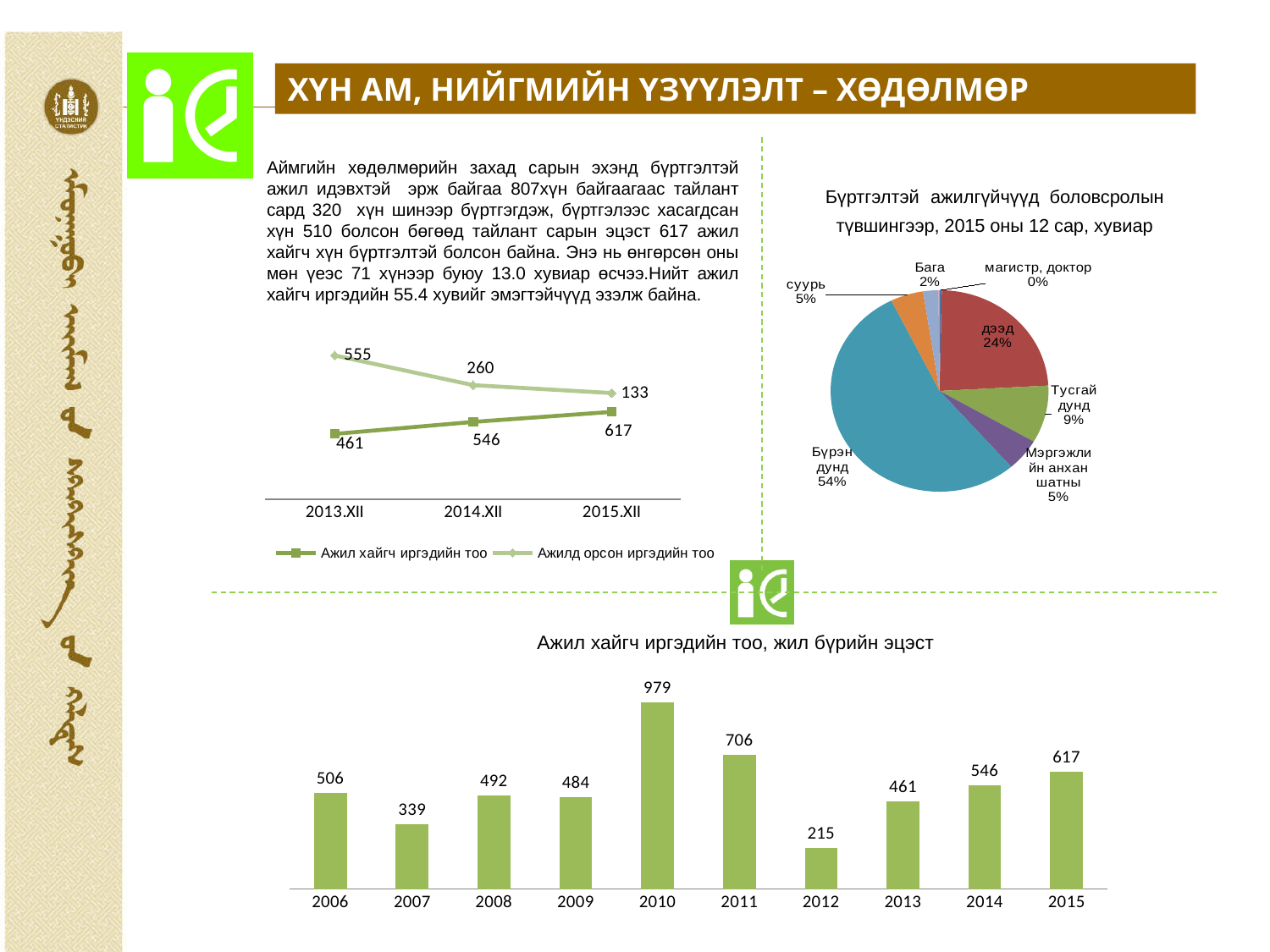
In the bar chart titled "Ажил хайгч иргэдийн тоо, жил бүрийн эцэст", how many years are shown? 10 In the pie chart titled "Бүртгэлтэй ажилгүйчүүд боловсролын түвшингээр, 2015 оны 12 сар, хувиар", which category has the largest share? Бүрэн дунд In the bar chart titled "Ажил хайгч иргэдийн тоо, жил бүрийн эцэст", what is the difference between the values for 2015 and 2014? 71 In the pie chart titled "Бүртгэлтэй ажилгүйчүүд боловсролын түвшингээр, 2015 оны 12 сар, хувиар", what share does "Бүрэн дунд" have? 54% In the pie chart titled "Бүртгэлтэй ажилгүйчүүд боловсролын түвшингээр, 2015 оны 12 сар, хувиар", what share does "дээд" have? 24% In the line chart on the left of the slide, how many series does the legend list? 2 What kind of chart is the chart at the bottom of the slide? bar chart In the bar chart titled "Ажил хайгч иргэдийн тоо, жил бүрийн эцэст", which year has the highest value? 2010 In the bar chart titled "Ажил хайгч иргэдийн тоо, жил бүрийн эцэст", which is larger, the value for 2006 or the value for 2008? 2006 In the line chart on the left of the slide, what is the value of "Ажилд орсон иргэдийн тоо" for 2014.XII? 260 In the bar chart titled "Ажил хайгч иргэдийн тоо, жил бүрийн эцэст", what is the value for 2010? 979 In the bar chart titled "Ажил хайгч иргэдийн тоо, жил бүрийн эцэст", which year has the lowest value? 2012